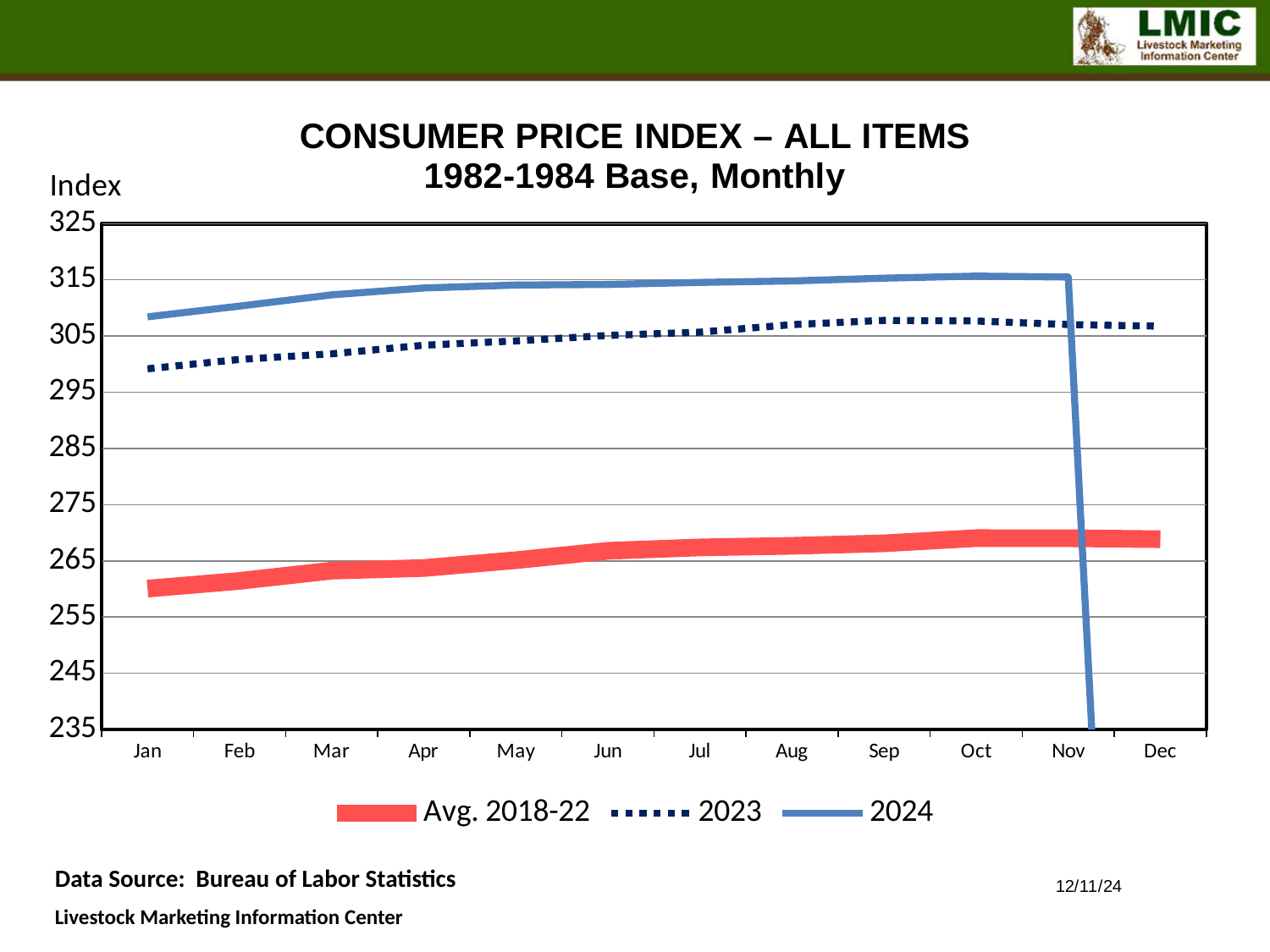
Which series has the highest value in Jan? 2024 How many months are shown along the x axis? 12 Is the value for Avg. 2018-22 in Jan greater or less than 265? less In Jun, which is larger: the 2024 value or the 2023 value? 2024 Does the Avg. 2018-22 series generally rise or fall from Jan to Dec? rise What kind of chart is shown on the slide? line chart Is the value for Avg. 2018-22 in Oct greater or less than 265? greater How many series does the legend list? 3 In Mar, which is larger: the Avg. 2018-22 value or the 2023 value? 2023 What is the title of the chart? CONSUMER PRICE INDEX – ALL ITEMS 1982-1984 Base, Monthly Is the value for 2023 in Jan greater or less than 305? less